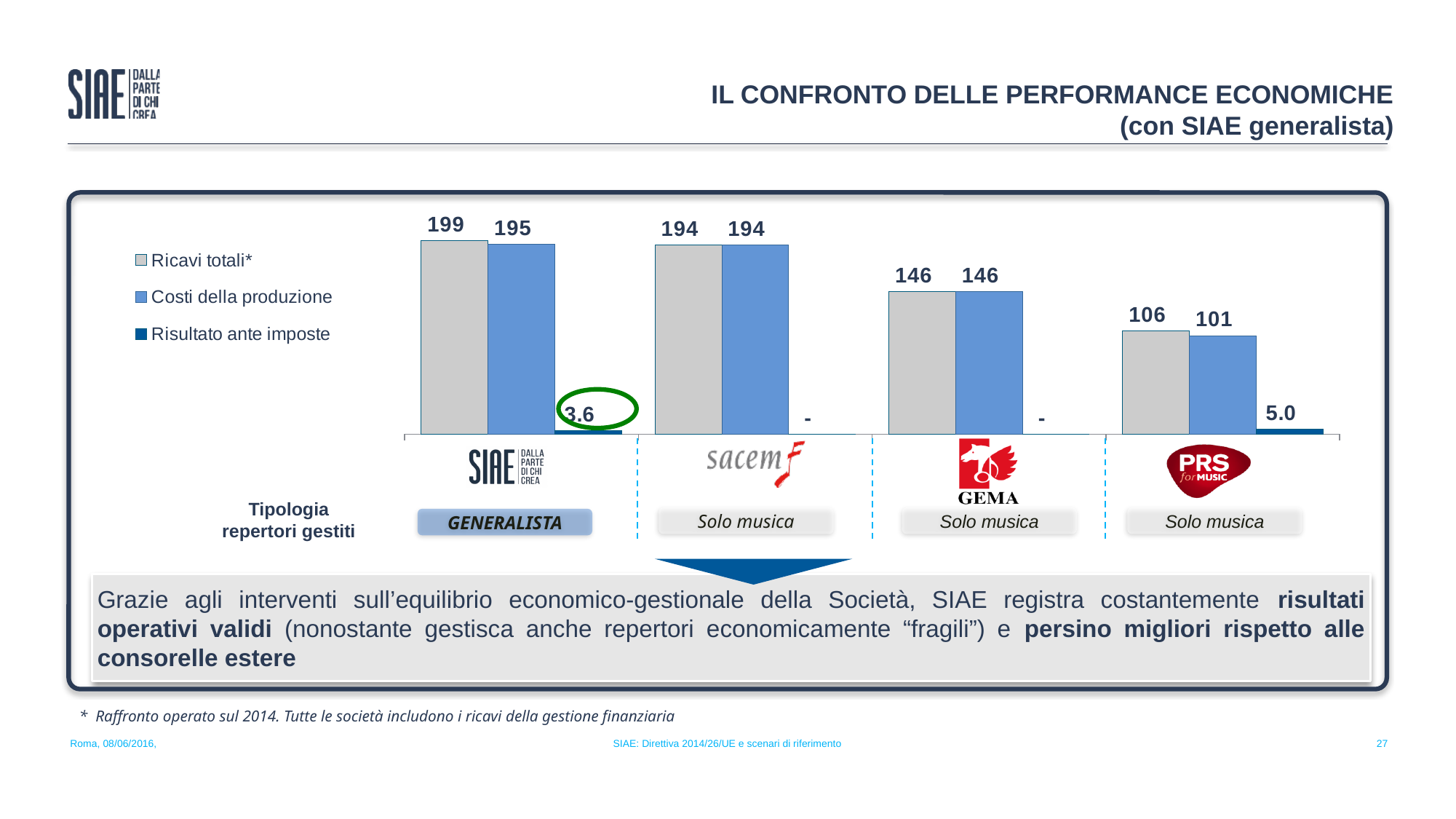
What is the difference between Ricavi totali* and Costi della produzione for PRS for Music? 5 Which is larger, the Ricavi totali* of SACEM or of GEMA? SACEM How many organisations are compared in the chart? 4 What kind of chart is shown on the slide? Bar chart How many series does the legend list? 3 What is the difference between Ricavi totali* and Costi della produzione for SIAE? 4 Which organisation has the lowest Costi della produzione? PRS for Music What is the Risultato ante imposte for SIAE? 3.6 Which organisation has the highest Ricavi totali*? SIAE What is the Risultato ante imposte for PRS for Music? 5.0 What is the value of Costi della produzione for PRS for Music? 101 What is the value of Ricavi totali* for SIAE? 199